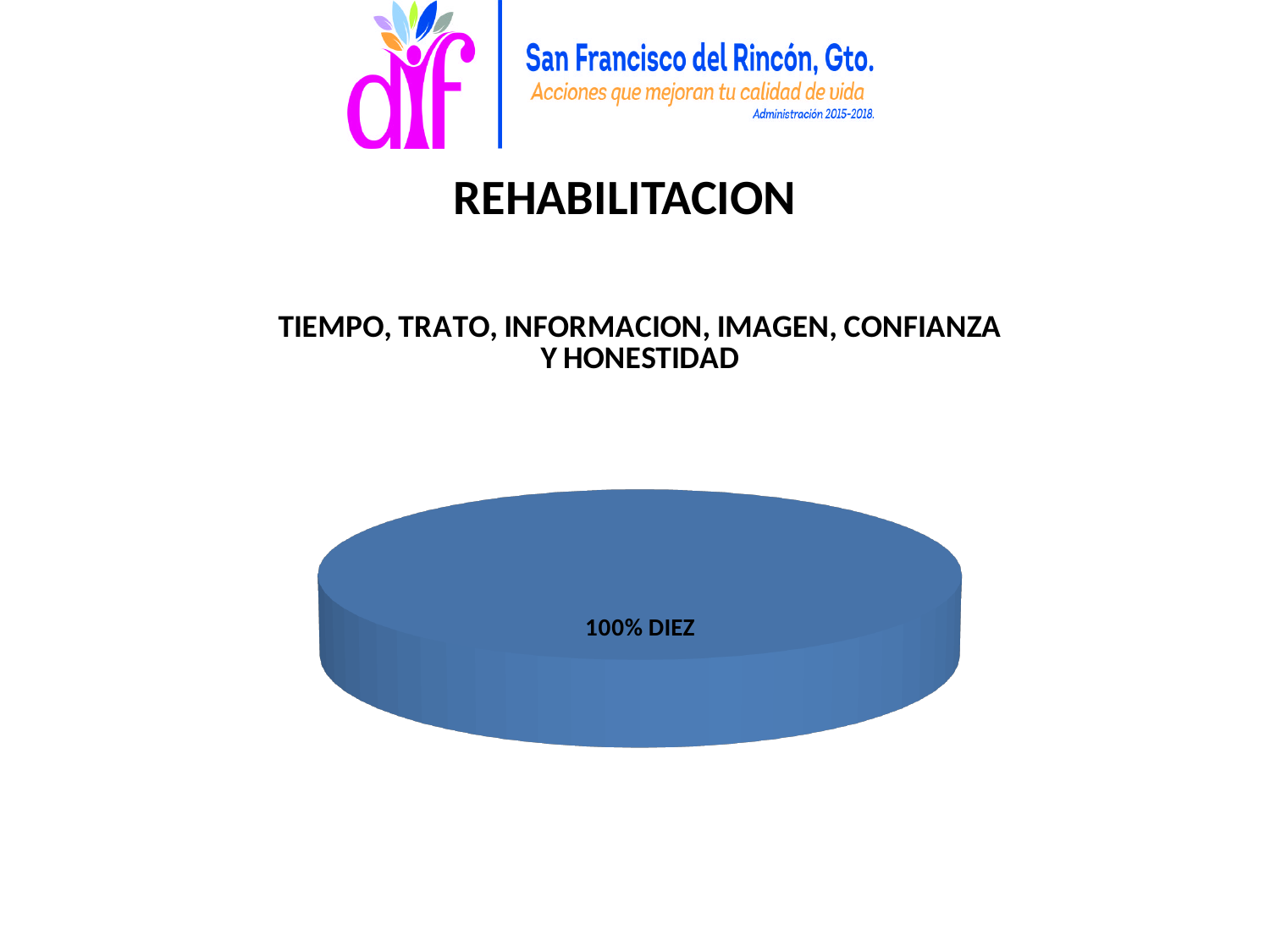
What kind of chart is shown on the slide? pie chart What colour is the pie chart slice? blue What share of the pie does the DIEZ slice represent? 100% What label is printed on the single slice of the pie chart? 100% DIEZ What is the title of the chart? TIEMPO, TRATO, INFORMACION, IMAGEN, CONFIANZA Y HONESTIDAD How many slices does the pie chart have? 1